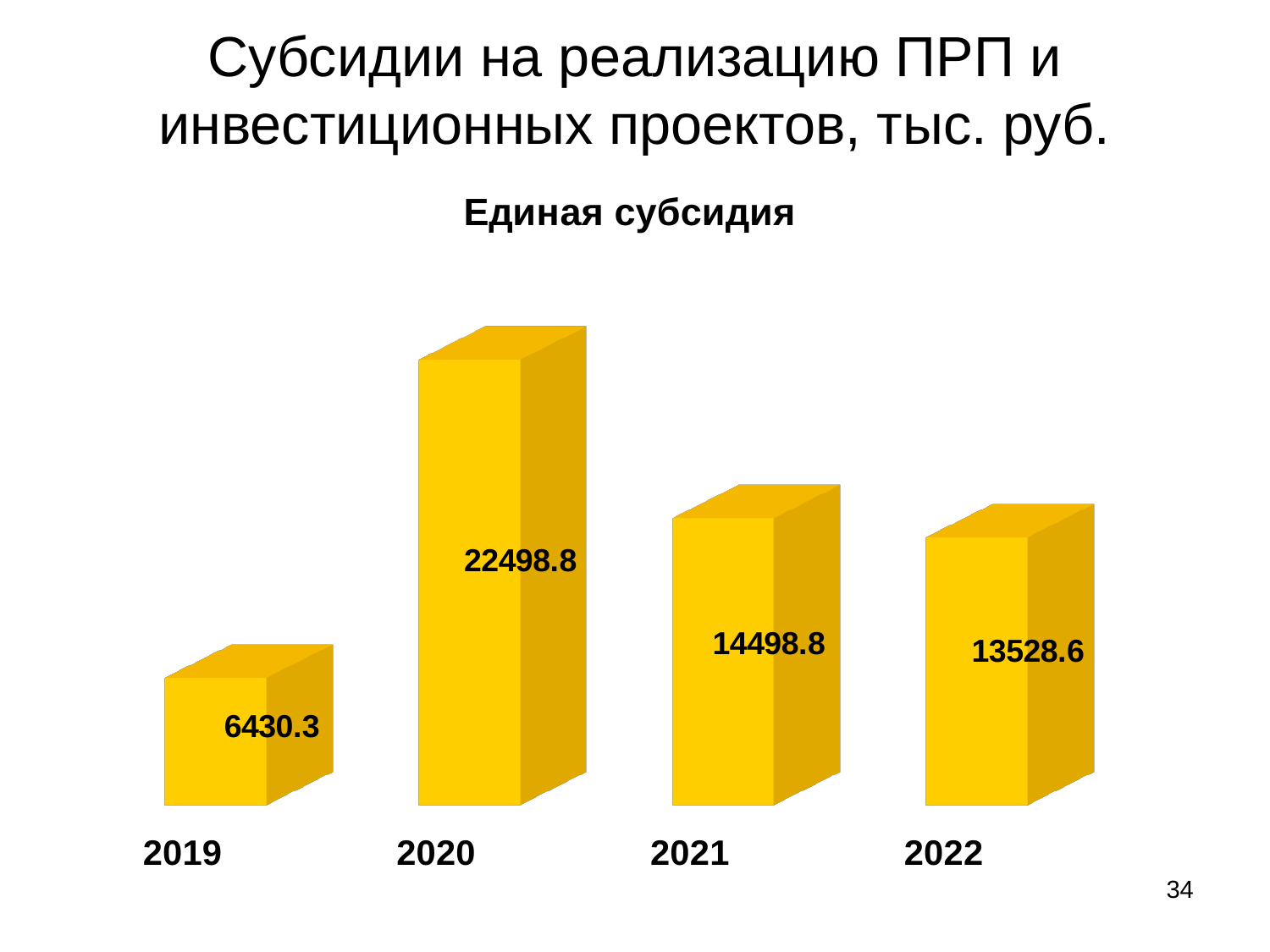
How many years are shown on the chart? 4 Which year has the highest value? 2020 What is the value for 2022? 13528.6 What kind of chart is this? bar chart What is the value for 2019? 6430.3 What is the value for 2020? 22498.8 Do the values rise or fall from 2020 to 2022? fall What is the title of the chart? Единая субсидия What is the difference between the values for 2020 and 2021? 8000 Which is larger, the value for 2021 or the value for 2022? 2021 What is the difference between the values for 2021 and 2022? 970.2 Which year has the lowest value? 2019